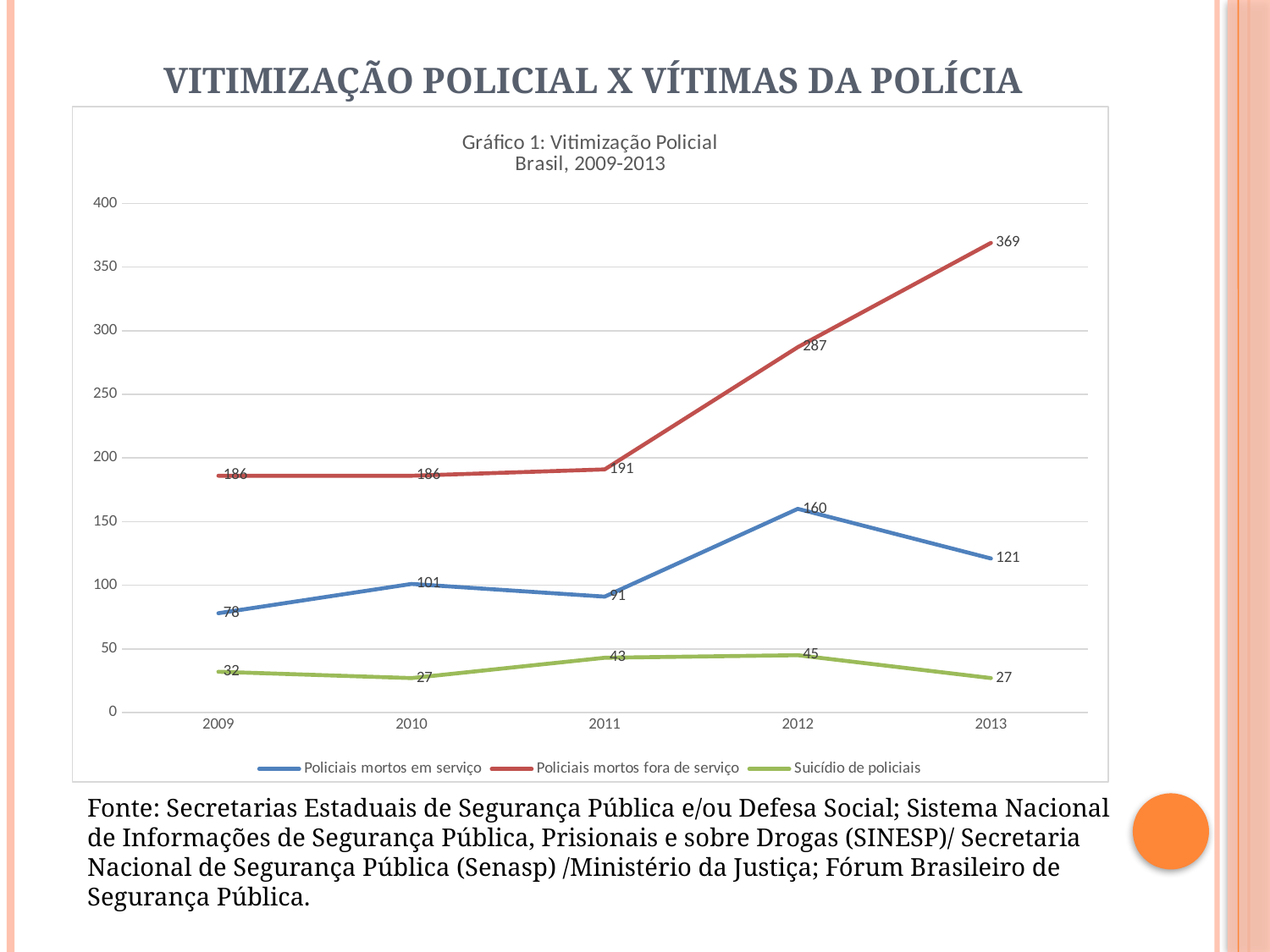
What is the value for Policiais mortos em serviço in 2012? 160 What type of chart is shown on the slide? line chart How many series does the legend list? 3 How many years are plotted on the x axis? 5 In which year is Policiais mortos em serviço lowest? 2009 Does Policiais mortos fora de serviço rise or fall from 2011 to 2013? rise What is the title of the chart? Gráfico 1: Vitimização Policial Brasil, 2009-2013 Which is larger: Policiais mortos em serviço in 2010 or in 2011? 2010 What is the value for Suicídio de policiais in 2010? 27 In which year is Policiais mortos em serviço highest? 2012 What is the difference between Policiais mortos fora de serviço in 2013 and in 2012? 82 What is the value for Policiais mortos fora de serviço in 2013? 369